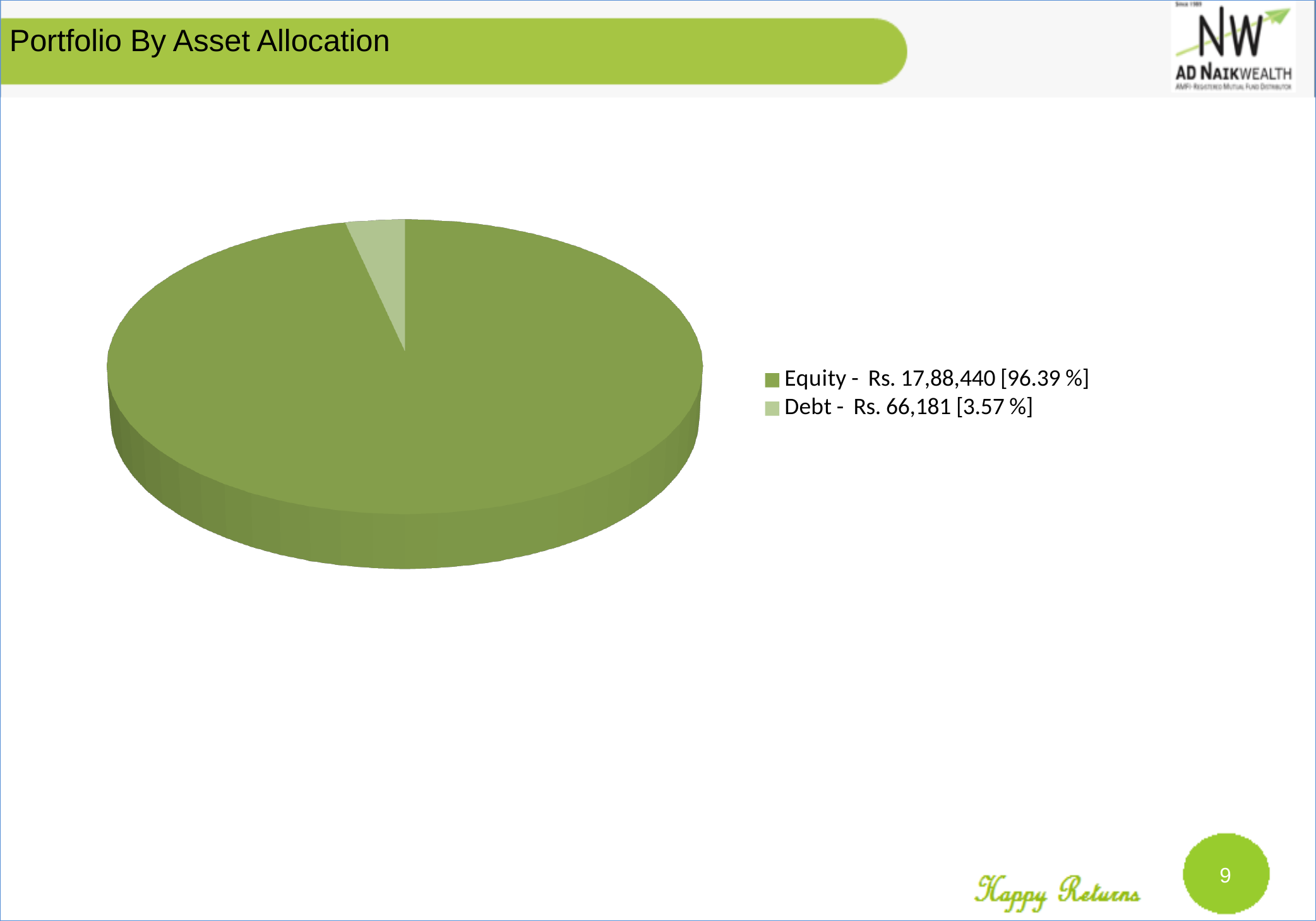
Which category has the smallest slice of the pie? Debt What share of the pie does Equity represent? 96.39 % Which is larger, the value for Equity or the value for Debt? Equity Which category is shown in the lighter green colour in the pie chart? Debt What is the value for Equity in the pie chart? Rs. 17,88,440 What share of the pie does Debt represent? 3.57 % What is the value for Debt in the pie chart? Rs. 66,181 What is the difference in percentage share between Equity and Debt? 92.82 % How many categories are shown in the pie chart? 2 What is the title of the slide containing the pie chart? Portfolio By Asset Allocation Which category has the largest slice of the pie? Equity What kind of chart is shown on the slide? Pie chart